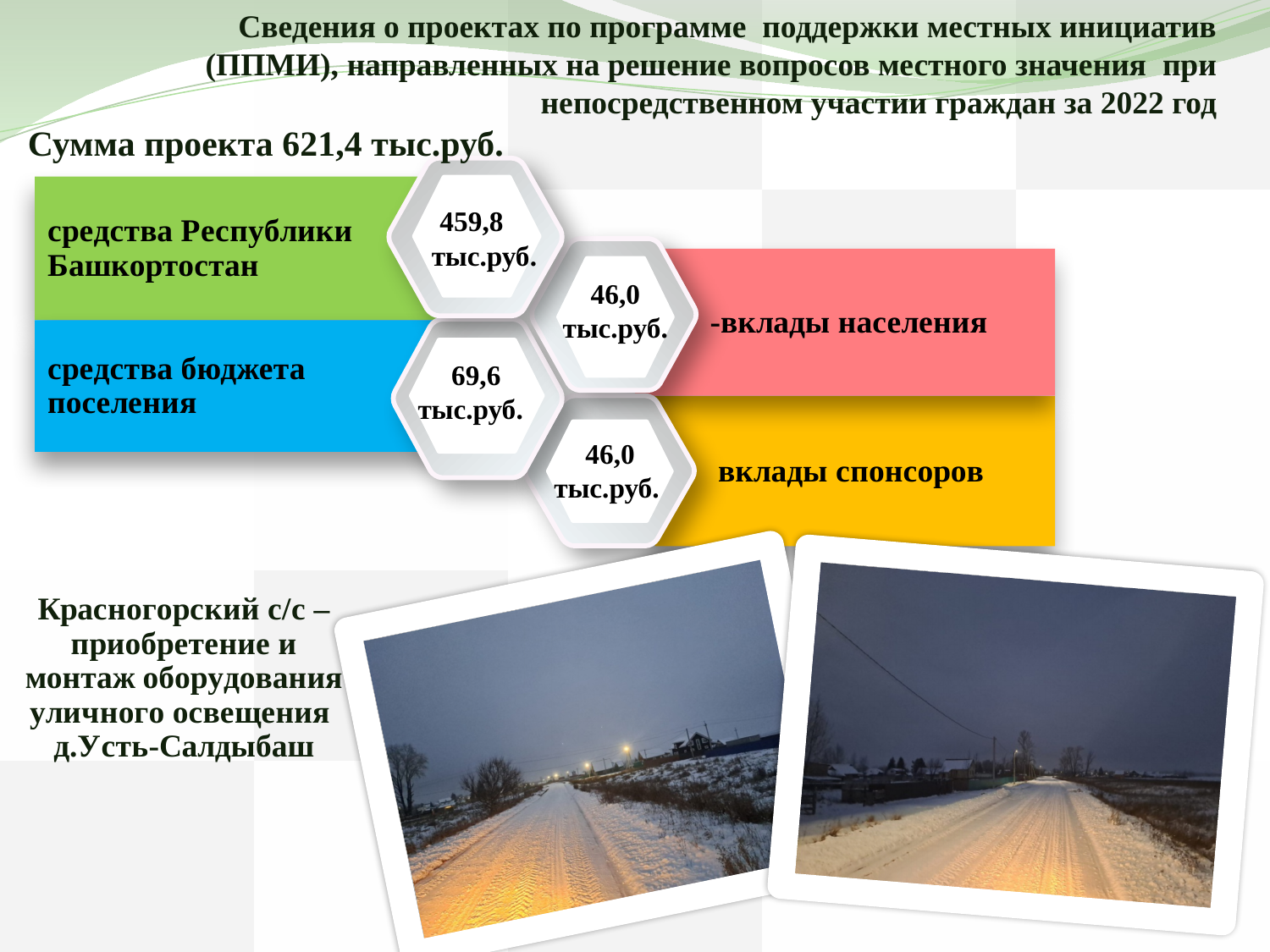
How many funding sources are shown in the diagram? 4 Which funding source has the largest amount? средства Республики Башкортостан Which is larger: "средства бюджета поселения" or "вклады населения"? средства бюджета поселения What amount is shown for "средства Республики Башкортостан"? 459,8 тыс.руб. What is the difference between the amount from "средства Республики Башкортостан" and "средства бюджета поселения"? 390,2 тыс.руб. What colour is the block labelled "средства бюджета поселения"? Blue What is the total project sum shown on the slide? 621,4 тыс.руб. What amount is shown for "средства бюджета поселения"? 69,6 тыс.руб. What colour is the block labelled "вклады спонсоров"? Yellow What is the combined amount of "вклады населения" and "вклады спонсоров"? 92,0 тыс.руб. What amount is shown for "вклады спонсоров"? 46,0 тыс.руб. What amount is shown for "вклады населения"? 46,0 тыс.руб.